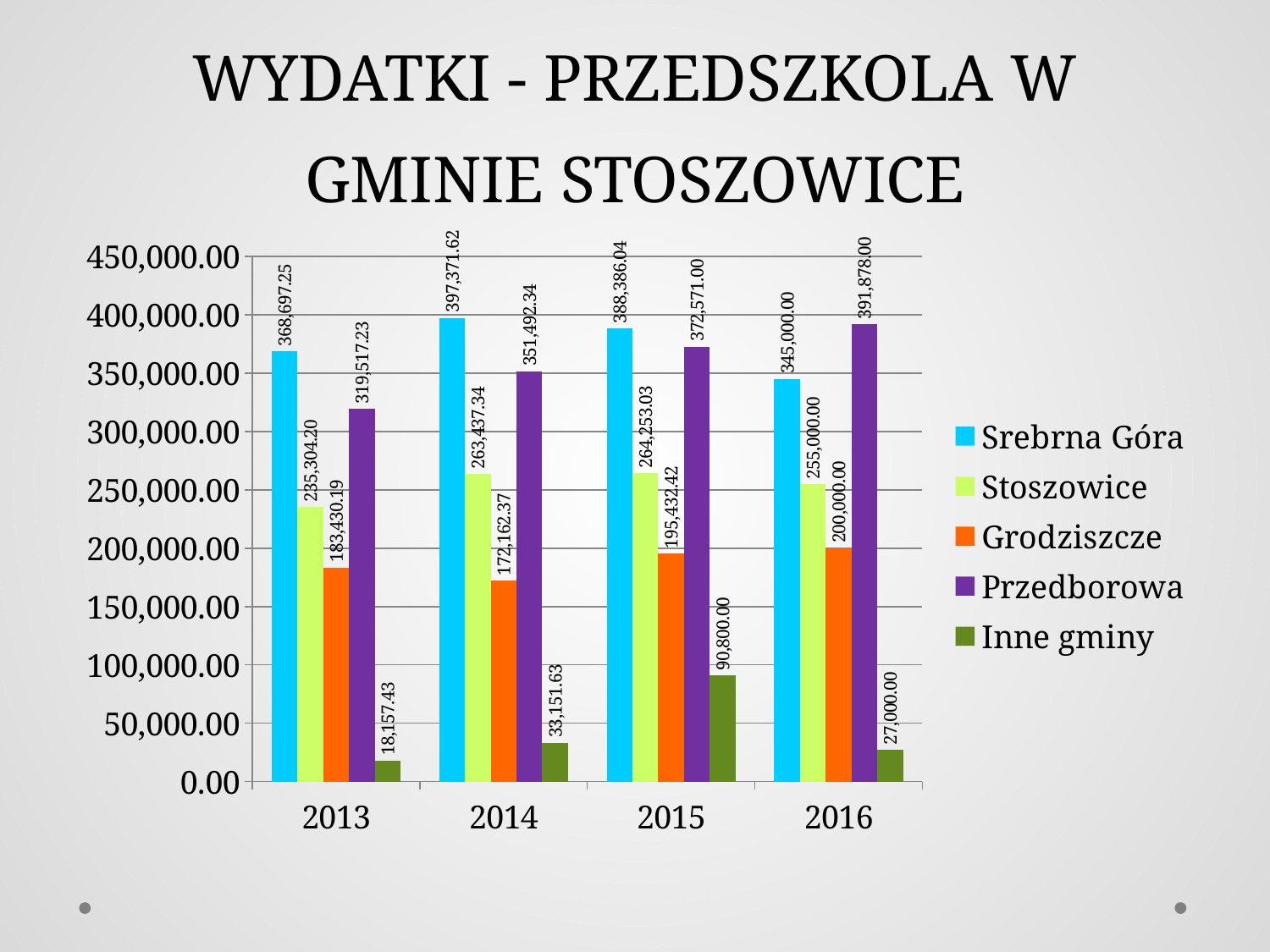
How many series does the legend list? 5 In which year is the value for Srebrna Góra the highest? 2014 What kind of chart is shown on the slide? Bar chart What is the difference between Przedborowa and Srebrna Góra in 2016? 46,878.00 In which year is the value for Inne gminy the lowest? 2013 What is the value for Inne gminy in 2015? 90,800.00 Do the values for Przedborowa rise or fall from 2013 to 2016? Rise What is the value for Srebrna Góra in 2014? 397,371.62 What is the value for Grodziszcze in 2013? 183,430.19 How many years are shown on the x axis? 4 What is the value for Przedborowa in 2016? 391,878.00 Which is larger in 2015: Srebrna Góra or Przedborowa? Srebrna Góra